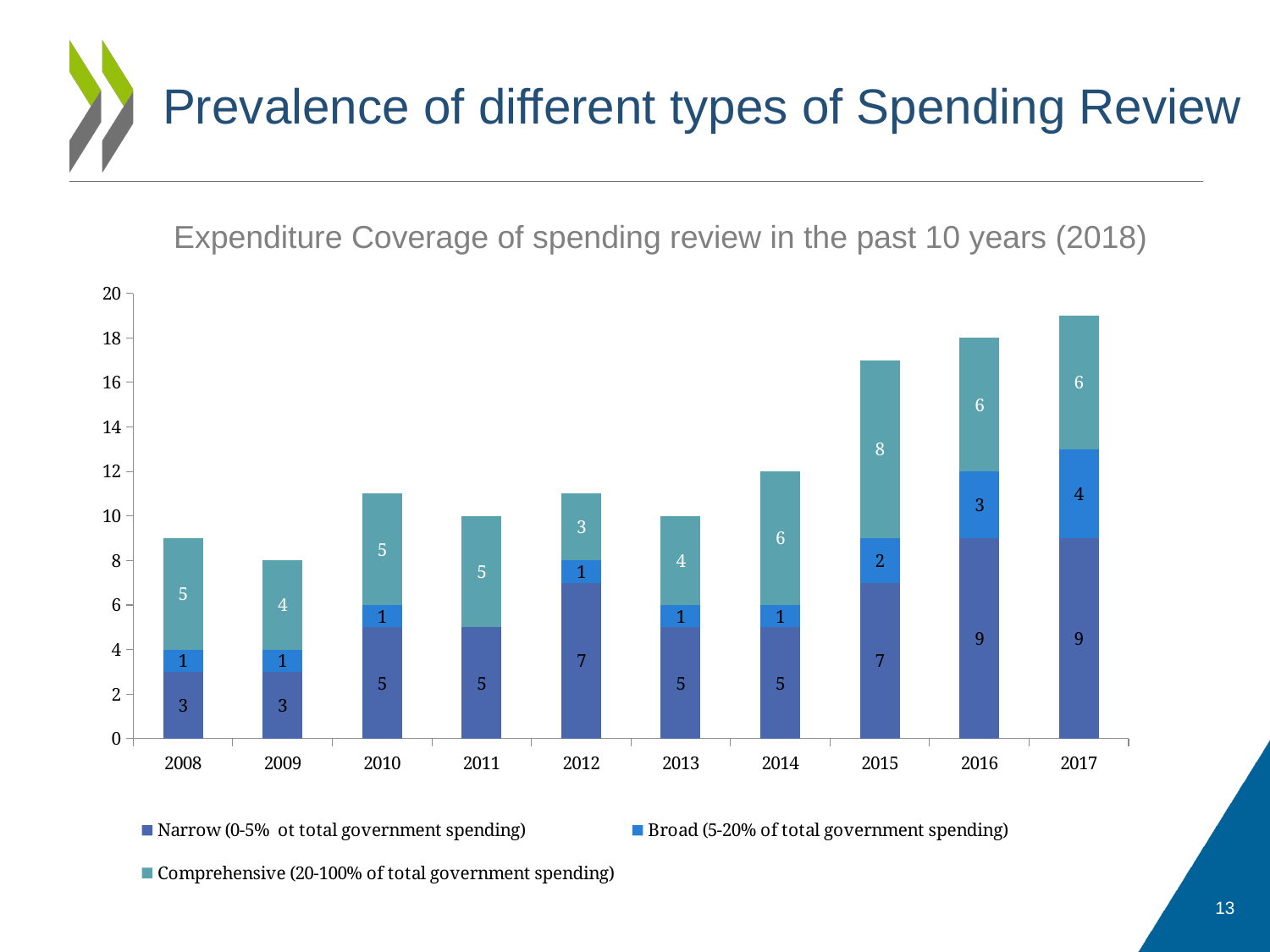
What is the difference between the Narrow values for 2017 and 2008? 6 What kind of chart is this? Stacked bar chart What is the Broad value for 2017? 4 Is the total stacked bar for 2015 greater or less than 16? greater How many years are shown on the x axis? 10 Is the Narrow value larger in 2012 or in 2013? 2012 What is the Narrow value for 2016? 9 Which year has the highest Comprehensive value? 2015 What is the total of the stacked bar for 2017? 19 How many series does the legend list? 3 Which year has the lowest total stacked bar? 2009 What is the Comprehensive value for 2015? 8